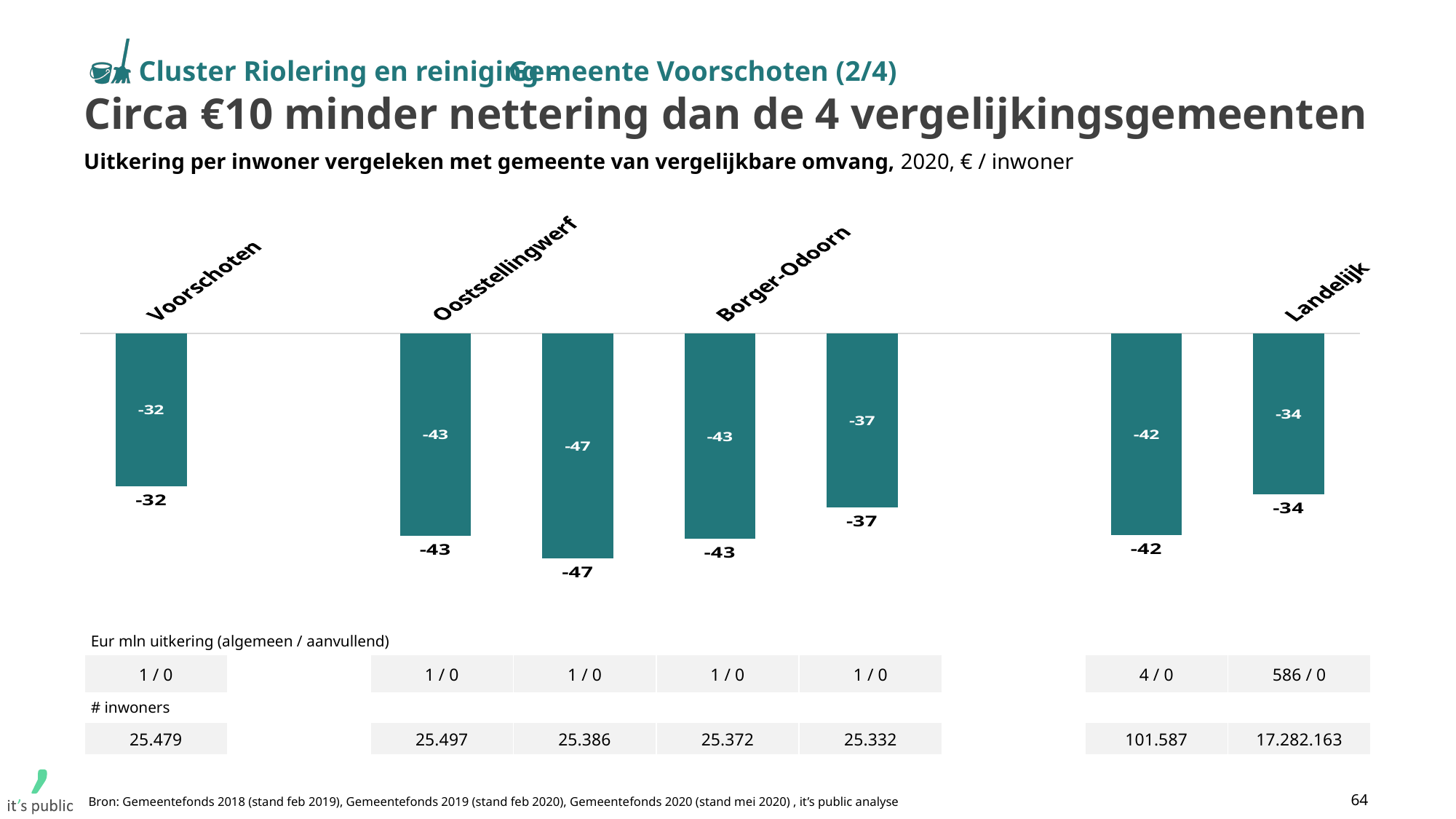
What is the difference between the values for Voorschoten and Ooststellingwerf? 11 Which category has the highest (least negative) value? Voorschoten What is the value for Landelijk? -34 What kind of chart is shown on the slide? bar chart What is the value for Ooststellingwerf? -43 Which is larger, the value for Voorschoten or the value for Borger-Odoorn? Voorschoten How many bars are plotted in the chart? 7 What is the value of the third bar from the left? -47 What is the value for Voorschoten? -32 What is the lowest value shown in the chart? -47 What is the value for Borger-Odoorn? -43 In what unit are the chart values expressed, according to the subtitle? € / inwoner